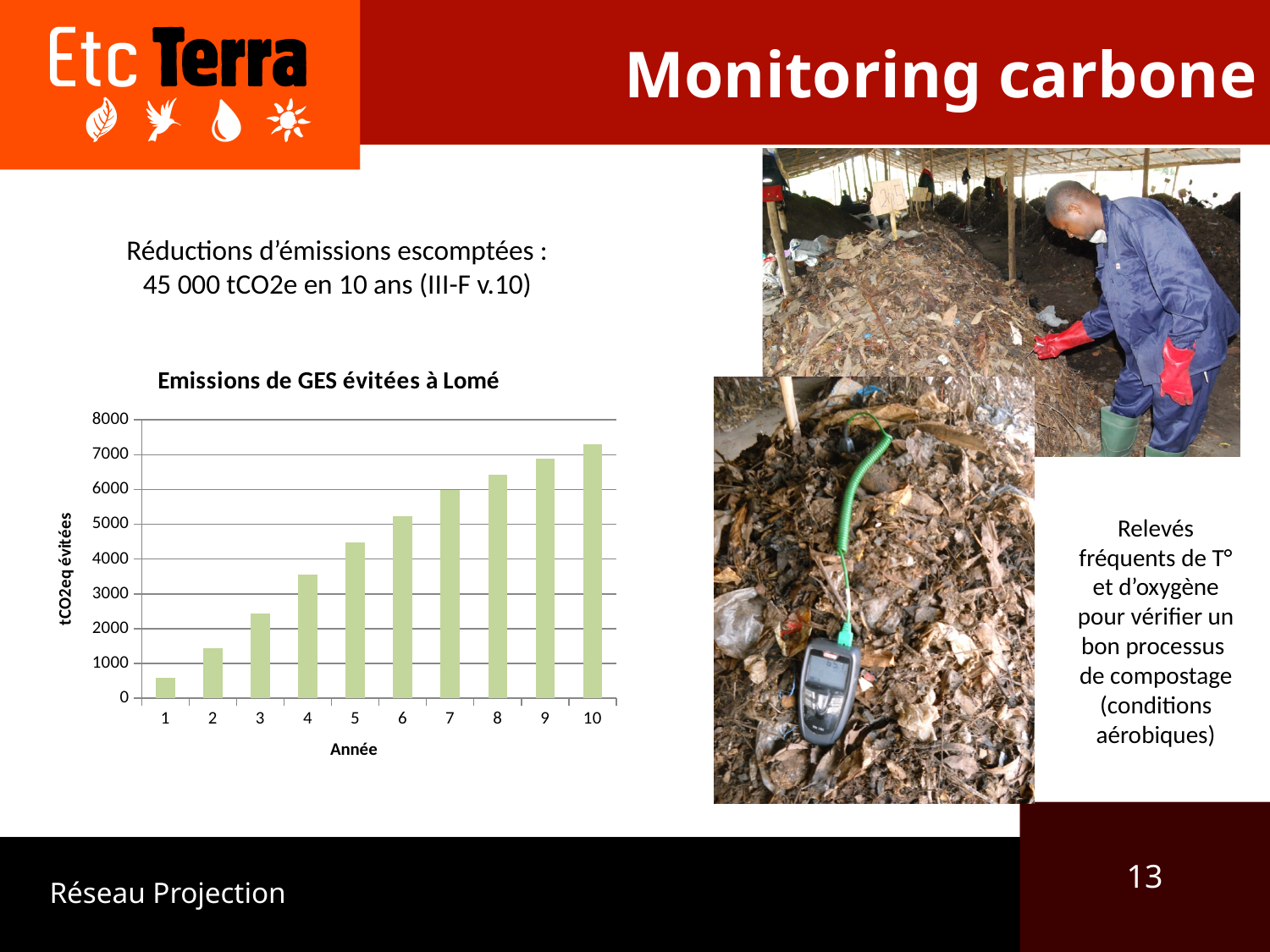
How many years (categories) are plotted on the x axis of the chart? 10 Which year has the highest value in the chart? 10 Is the value for year 1 greater or less than 1000? less What is the title of the chart? Emissions de GES évitées à Lomé Is the value for year 10 greater or less than 7000? greater Do the values rise or fall from year 1 to year 10? rise Which is larger, the value for year 4 or the value for year 7? year 7 Is the value for year 5 greater or less than 4000? greater What is the label of the y axis of the chart? tCO2eq évitées What kind of chart is shown on the slide? bar chart Which year has the lowest value in the chart? 1